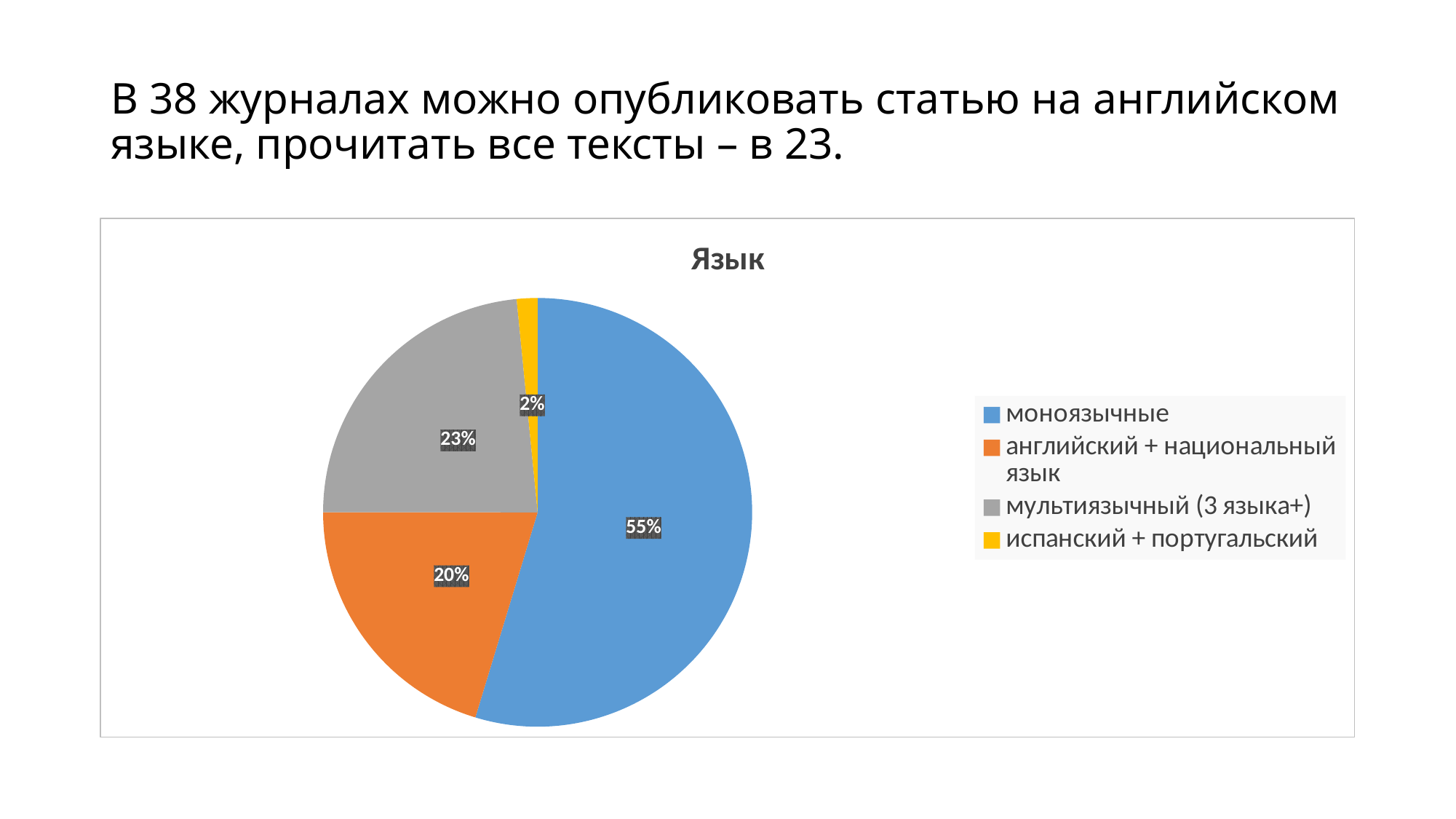
What share of the pie is labelled 'моноязычные'? 55% What type of chart is shown on the slide? pie chart What is the title of the chart? Язык Which category has the smallest slice of the pie? испанский + португальский Which is larger: the slice for 'мультиязычный (3 языка+)' or the slice for 'английский + национальный язык'? мультиязычный (3 языка+) What share of the pie is labelled 'английский + национальный язык'? 20% What share of the pie is labelled 'испанский + португальский'? 2% How many categories does the pie chart have? 4 What colour is the slice for 'испанский + португальский'? yellow Which category has the largest slice of the pie? моноязычные What is the difference in percentage points between 'моноязычные' and 'мультиязычный (3 языка+)'? 32